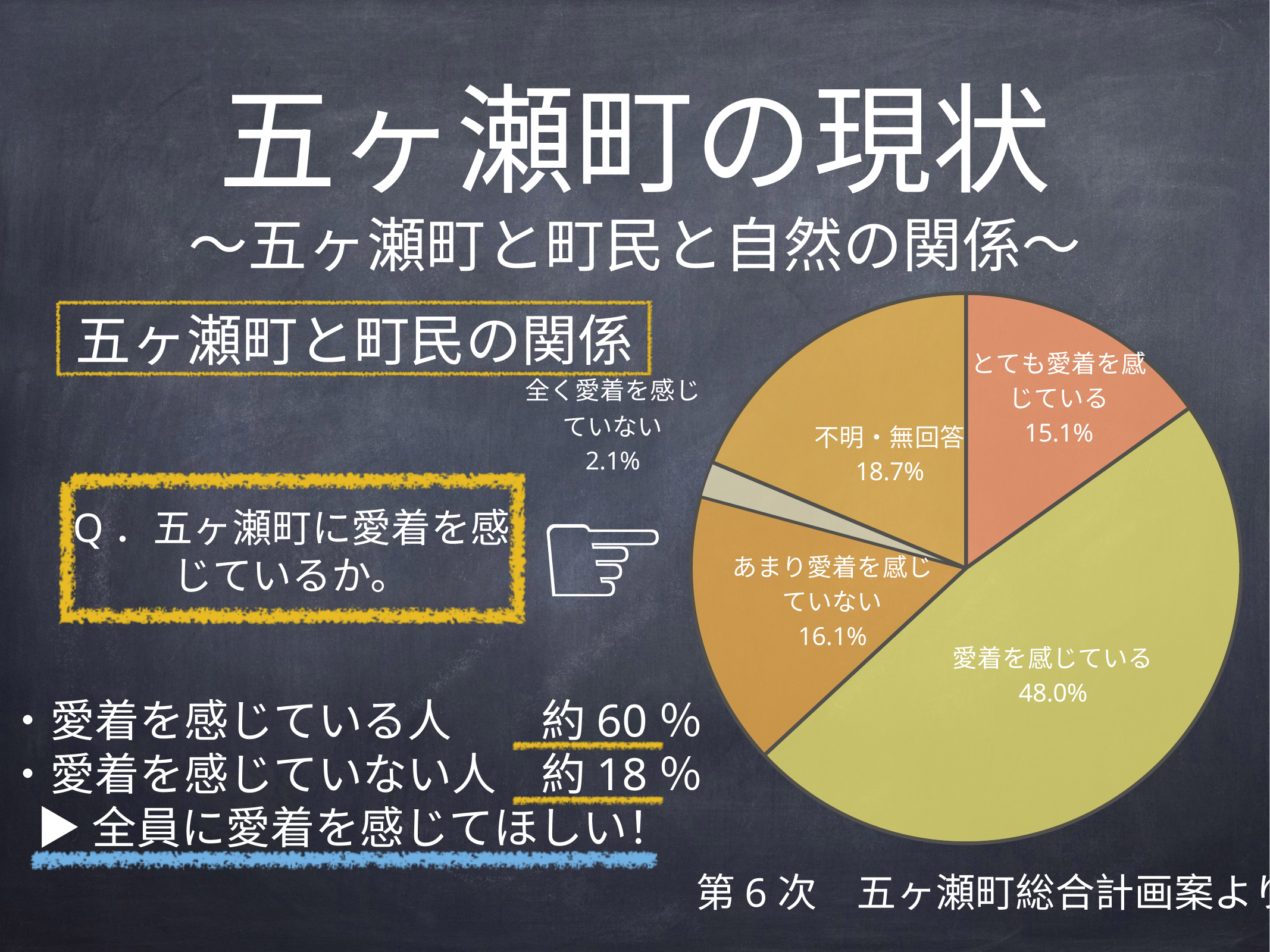
What is the difference in percentage points between 愛着を感じている and とても愛着を感じている? 32.9 Which slice of the pie chart is the smallest? 全く愛着を感じていない Which is larger in the pie chart, 不明・無回答 or あまり愛着を感じていない? 不明・無回答 How many slices does the pie chart have? 5 What is the combined share of とても愛着を感じている and 愛着を感じている? 63.1% What kind of chart is shown on the slide? pie chart What share of the pie is labelled 愛着を感じている? 48.0% What share of the pie is labelled 全く愛着を感じていない? 2.1% Which slice of the pie chart is the largest? 愛着を感じている What share of the pie is labelled とても愛着を感じている? 15.1% What share of the pie is labelled あまり愛着を感じていない? 16.1% What share of the pie is labelled 不明・無回答? 18.7%